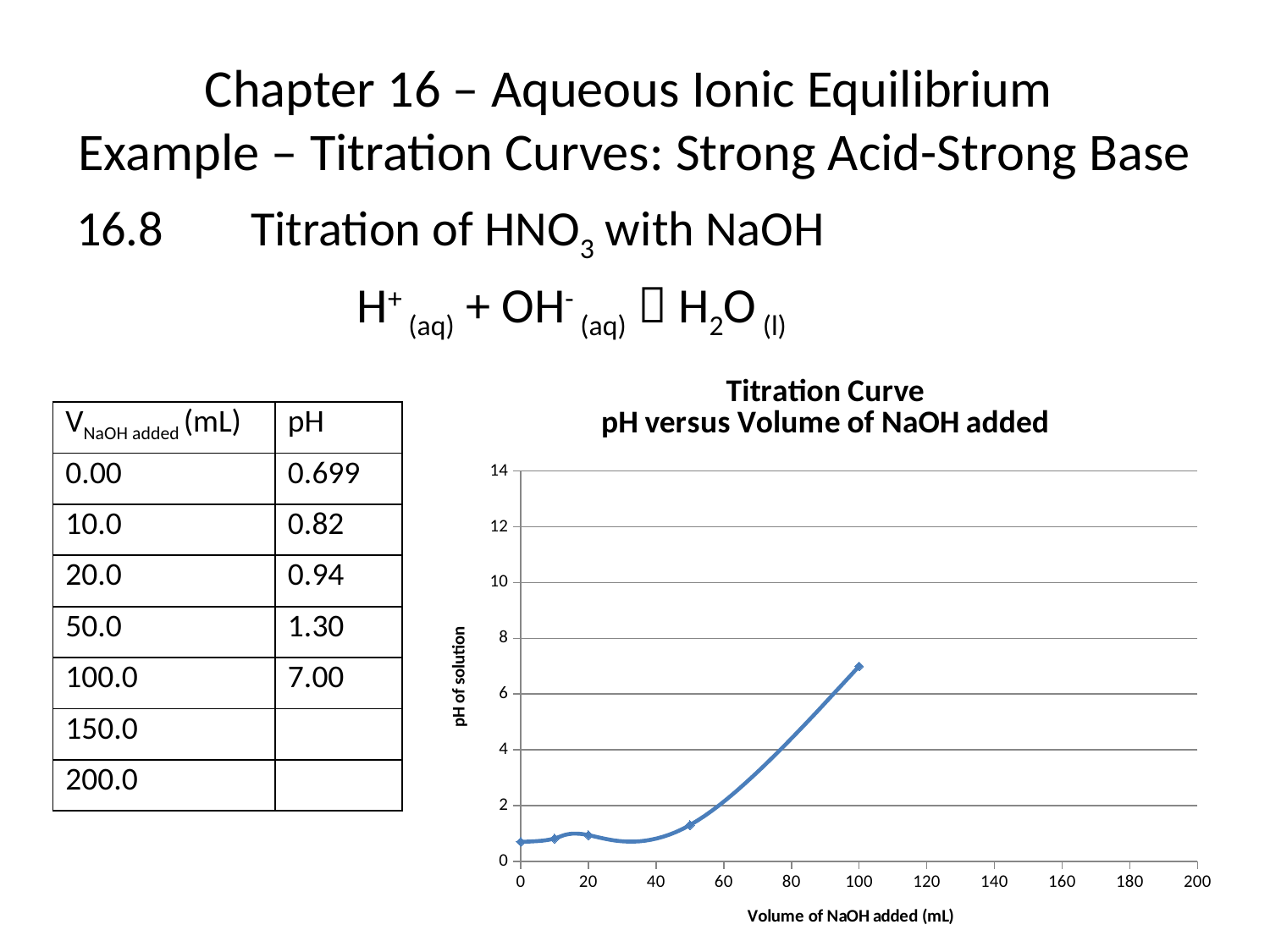
At which volume of NaOH added is the plotted pH highest? 100 Which has the larger pH on the chart: 50 mL or 100 mL of NaOH added? 100 mL What kind of chart is shown on the slide? line chart What is the title of the chart? Titration Curve pH versus Volume of NaOH added Is the pH at 100 mL of NaOH added greater or less than 6? greater Is the pH at 50 mL of NaOH added greater or less than 2? less Is the pH at 20 mL of NaOH added greater or less than 2? less What is the pH at 100.0 mL of NaOH added, as given in the table on the slide? 7.00 What is the highest value shown on the chart's x axis? 200 How many data points are plotted on the chart? 5 What is the label of the chart's vertical axis? pH of solution Does the pH rise or fall as the volume of NaOH added increases along the x axis? rise